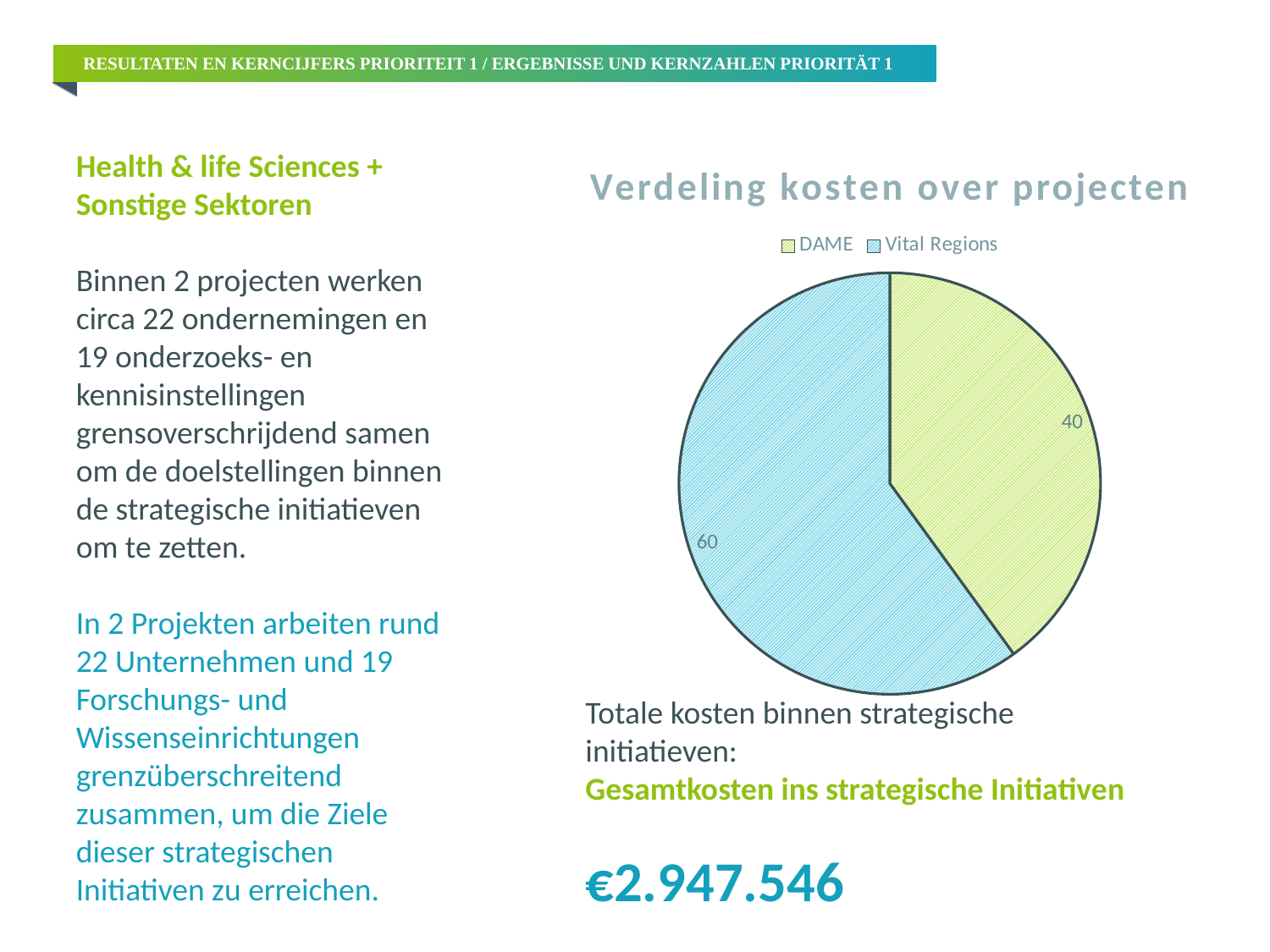
What share of the pie does the Vital Regions slice represent? 60% What is the title of the chart? Verdeling kosten over projecten How many entries does the chart legend list? 2 What is the difference between the values for Vital Regions and DAME? 20 Which project has the smallest slice of the pie chart? DAME Which project has the largest slice of the pie chart? Vital Regions What is the value shown for Vital Regions in the pie chart? 60 What is the value shown for DAME in the pie chart? 40 Which legend entry is shown in blue? Vital Regions What kind of chart is shown on the slide? Pie chart How many slices does the pie chart have? 2 Which is larger, the value for DAME or the value for Vital Regions? Vital Regions